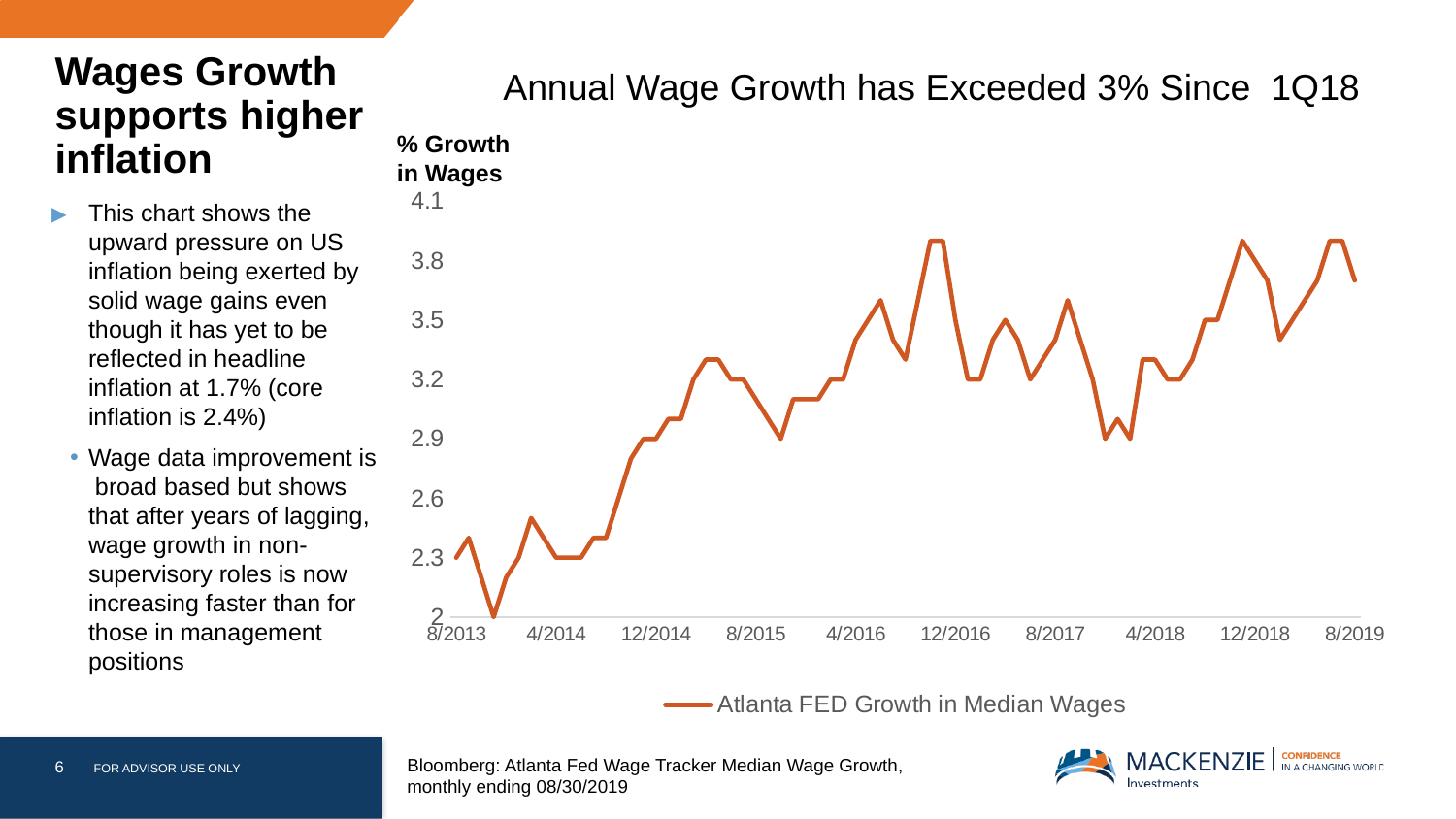
Is the value for 8/2013 greater or less than 2.6? less Is the value for 8/2019 greater or less than 3.5? greater What type of chart is shown on the slide? line chart Overall, does wage growth rise or fall from 8/2013 to 8/2019? rise How many series does the legend list? 1 Is the value for 12/2018 greater or less than 3.2? greater Which is larger, the value for 8/2013 or the value for 8/2019? 8/2019 What is the title of the chart? Annual Wage Growth has Exceeded 3% Since 1Q18 What is the name of the series shown in the legend? Atlanta FED Growth in Median Wages